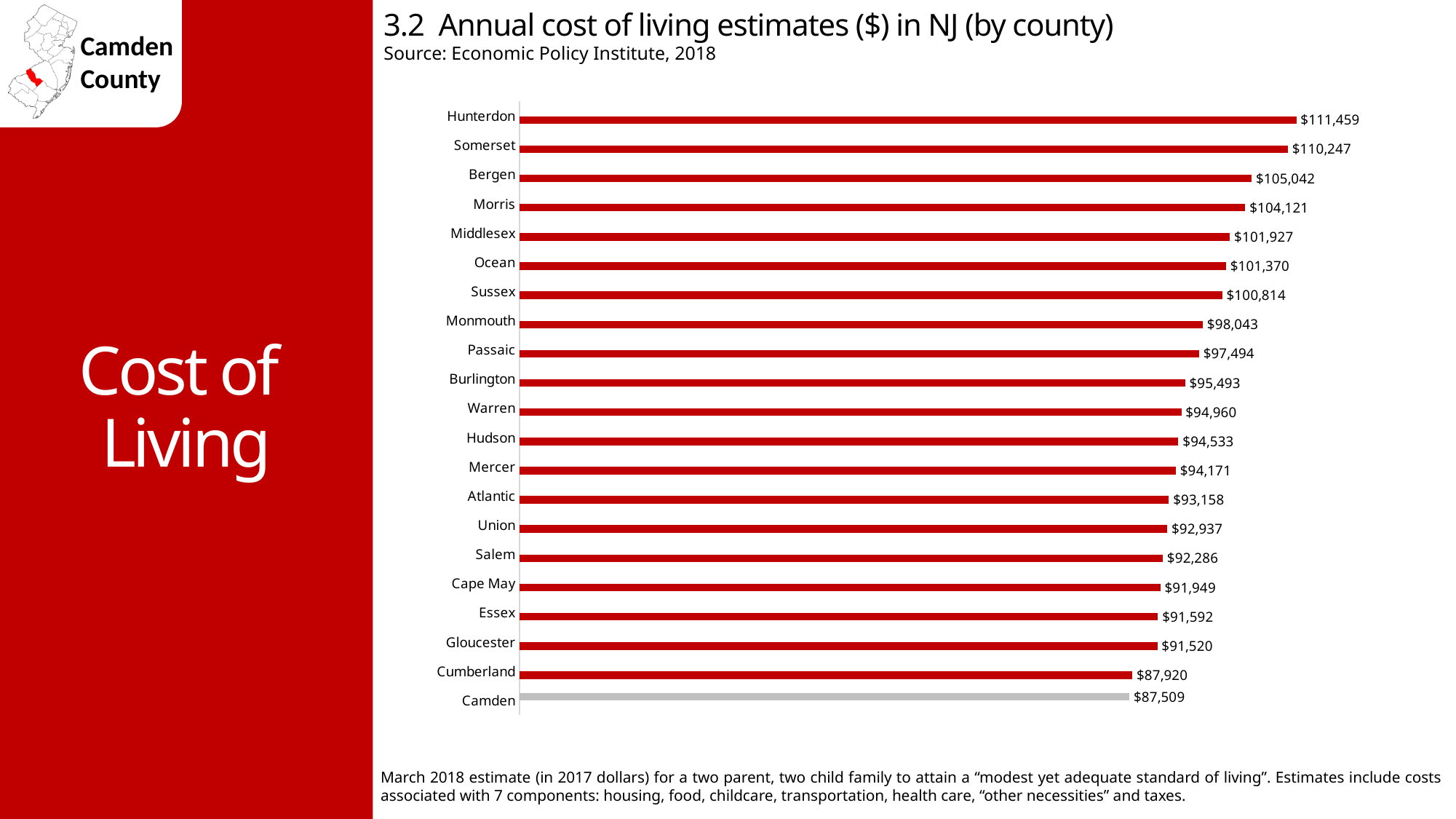
What is the difference between the cost of living estimates for Hunterdon and Camden? $23,950 Do the cost of living values increase or decrease going from the top county to the bottom county? Decrease Which county has a higher cost of living estimate, Somerset or Bergen? Somerset What is the difference between the cost of living estimates for Cumberland and Camden? $411 What kind of chart is shown on the slide? Bar chart What is the annual cost of living estimate for Camden County? $87,509 What is the annual cost of living estimate for Bergen County? $105,042 Which county has the lowest annual cost of living estimate? Camden Which county has the highest annual cost of living estimate? Hunterdon Which county's bar is coloured grey instead of red? Camden How many counties are shown in the chart? 21 What is the annual cost of living estimate for Gloucester County? $91,520